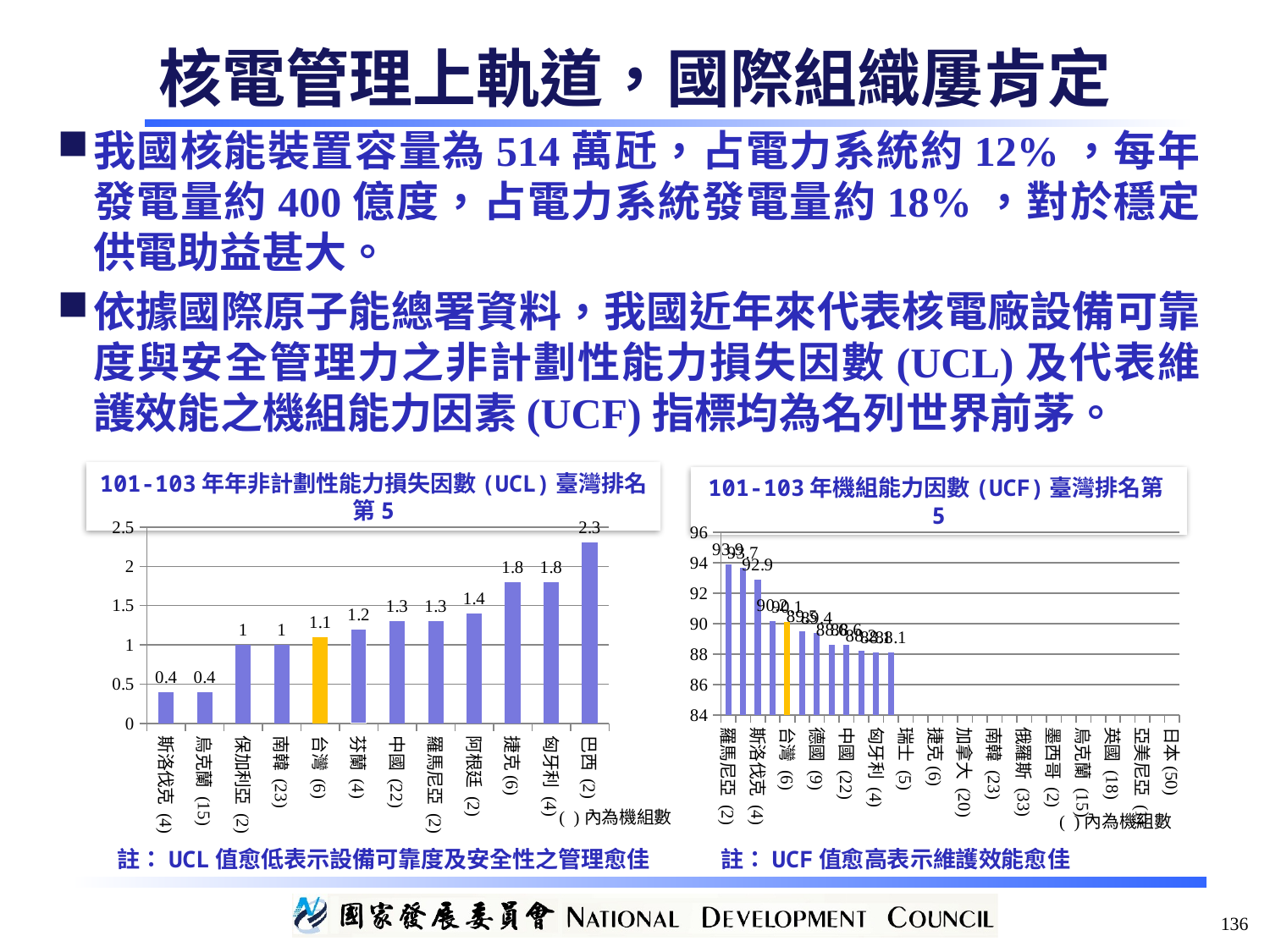
In the left chart (UCL), what is the value for 台灣? 1.1 In the left chart (UCL), what is the difference between the values for 巴西 and 台灣? 1.2 In the left chart (UCL), what is the value for 捷克? 1.8 In the left chart (UCL), how many countries are plotted? 12 What kind of chart is the left chart (UCL)? Bar chart In the left chart (UCL), which country has the highest value? 巴西 In the left chart (UCL), do the values rise or fall from left to right? Rise In the left chart (UCL), what colour is the bar for 台灣? Orange In the left chart (UCL), which has the larger value, 芬蘭 or 中國? 中國 According to the right chart's title, what is Taiwan's ranking for 機組能力因數 (UCF)? 第5 What kind of chart is the right chart (UCF)? Bar chart In the left chart (UCL), what is the value for 巴西? 2.3